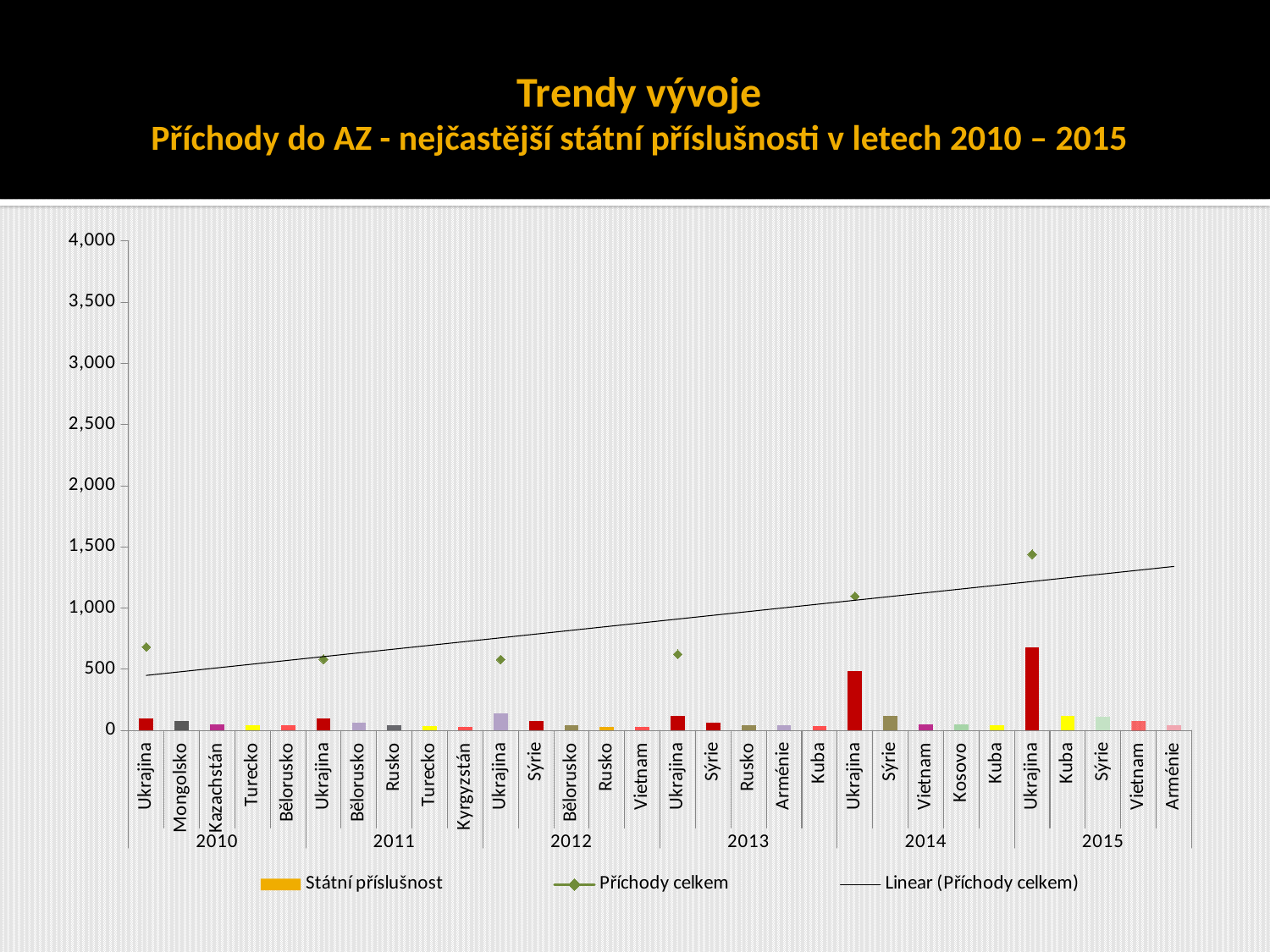
Is the Příchody celkem value for 2010 greater or less than 1,000? less How many years are shown along the x axis? 6 Which nationality has the tallest bar in 2014? Ukrajina Is the Příchody celkem value for 2015 greater or less than 1,000? greater What kind of chart is shown on the slide? bar chart with a line series How many series does the legend list? 3 Does the Linear (Příchody celkem) trend line rise or fall from 2010 to 2015? rise Is the bar for Ukrajina in 2015 greater or less than 500? greater How many nationality bars are shown for the year 2015? 5 In which year is the Příchody celkem value highest? 2015 Which nationality has the tallest bar in the whole chart? Ukrajina (2015) Which is larger, the bar for Ukrajina in 2014 or the bar for Ukrajina in 2015? Ukrajina in 2015